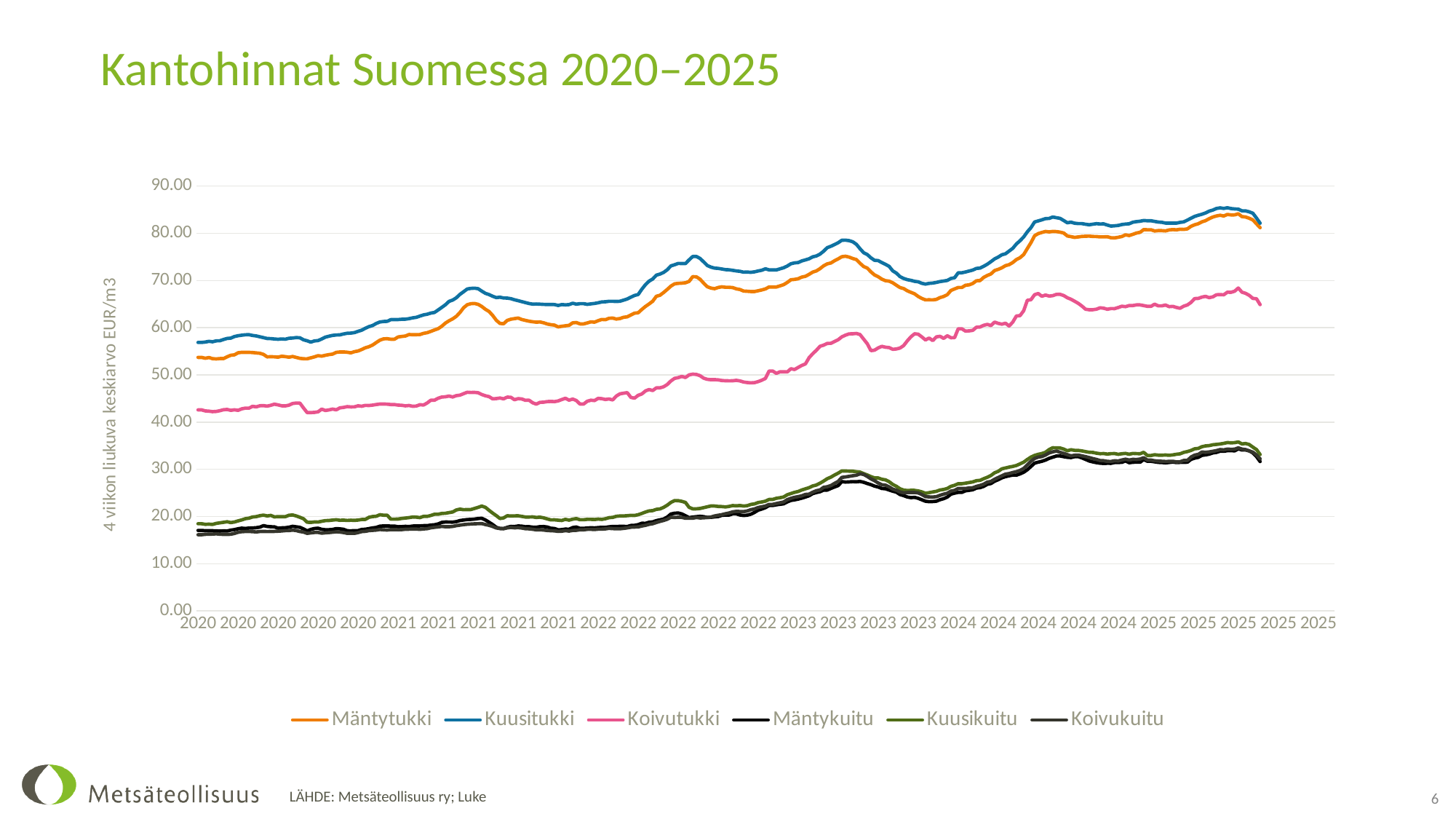
Is the value for Koivutukki at the start of 2020 greater or less than 50? less What is the title of the chart? Kantohinnat Suomessa 2020–2025 Is the value for Kuusitukki at the start of 2020 greater or less than 50? greater What source is cited for the chart data? Metsäteollisuus ry; Luke At the start of 2020, which is larger: Kuusikuitu or Mäntykuitu? Kuusikuitu Does the Kuusitukki series generally rise or fall from 2020 to 2025? rise What kind of chart is shown on the slide? line chart Which series has the highest values across the chart? Kuusitukki Is the value for Kuusikuitu at the end of the series in 2025 greater or less than 30? greater How many series does the legend list? 6 In 2022, which series is larger: Mäntytukki or Koivutukki? Mäntytukki